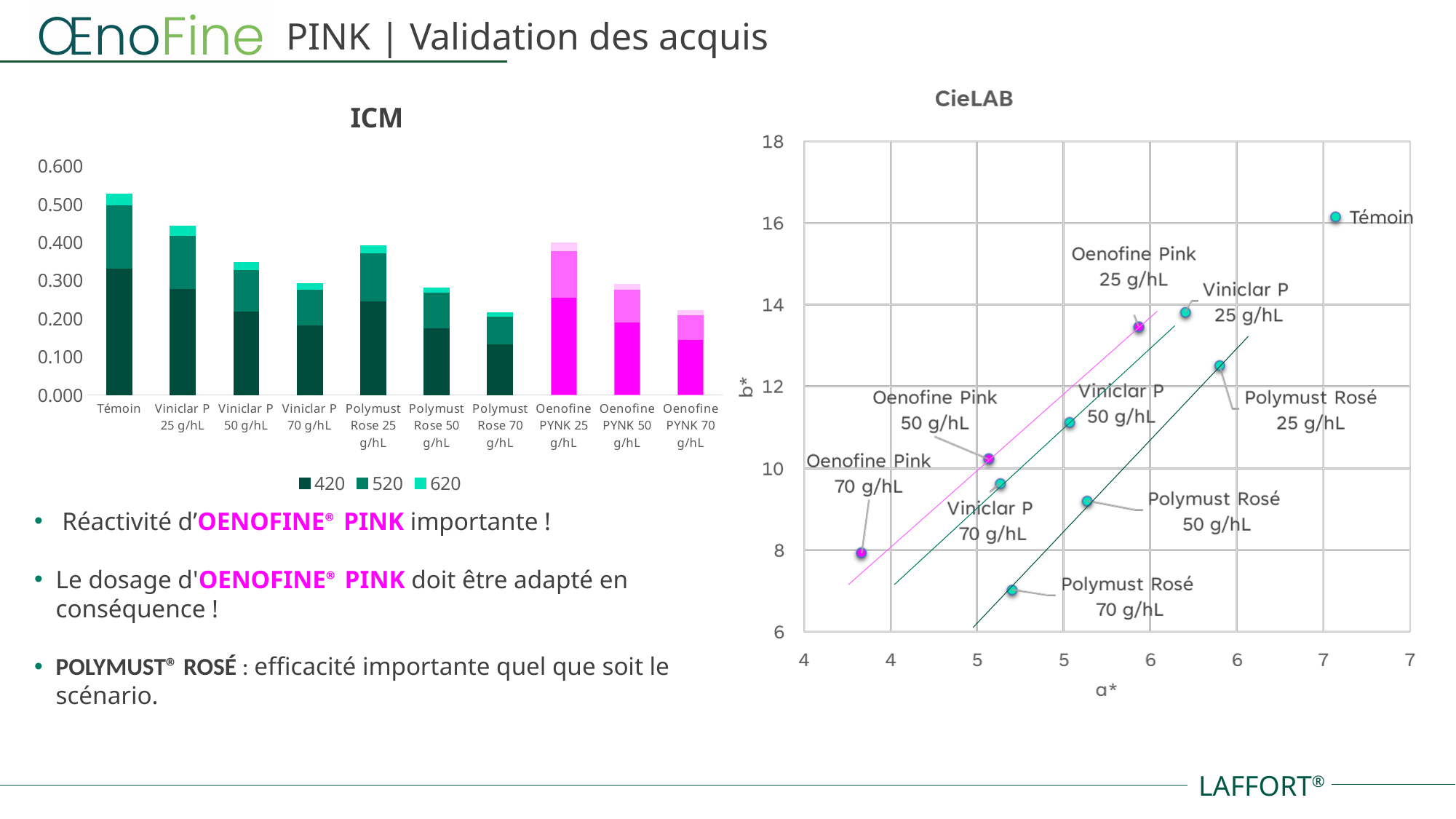
In the ICM chart, is the total value for Polymust Rose 70 g/hL greater or less than 0.300? less In the ICM chart, which category has the highest total bar? Témoin How many categories are shown on the x axis of the ICM chart? 10 In the ICM chart, which total bar is larger: Viniclar P 50 g/hL or Polymust Rose 50 g/hL? Viniclar P 50 g/hL What kind of chart is the ICM chart? stacked bar chart In the CieLAB chart, is the b* value for Témoin greater or less than 14? greater What kind of chart is the CieLAB chart? scatter chart What are the axis titles of the CieLAB chart? a* (x axis) and b* (y axis) In the CieLAB chart, which point has the highest b* value? Témoin How many series does the legend of the ICM chart list? 3 In the CieLAB chart, which point has the lowest b* value? Polymust Rosé 70 g/hL In the ICM chart, is the total value for Témoin greater or less than 0.500? greater